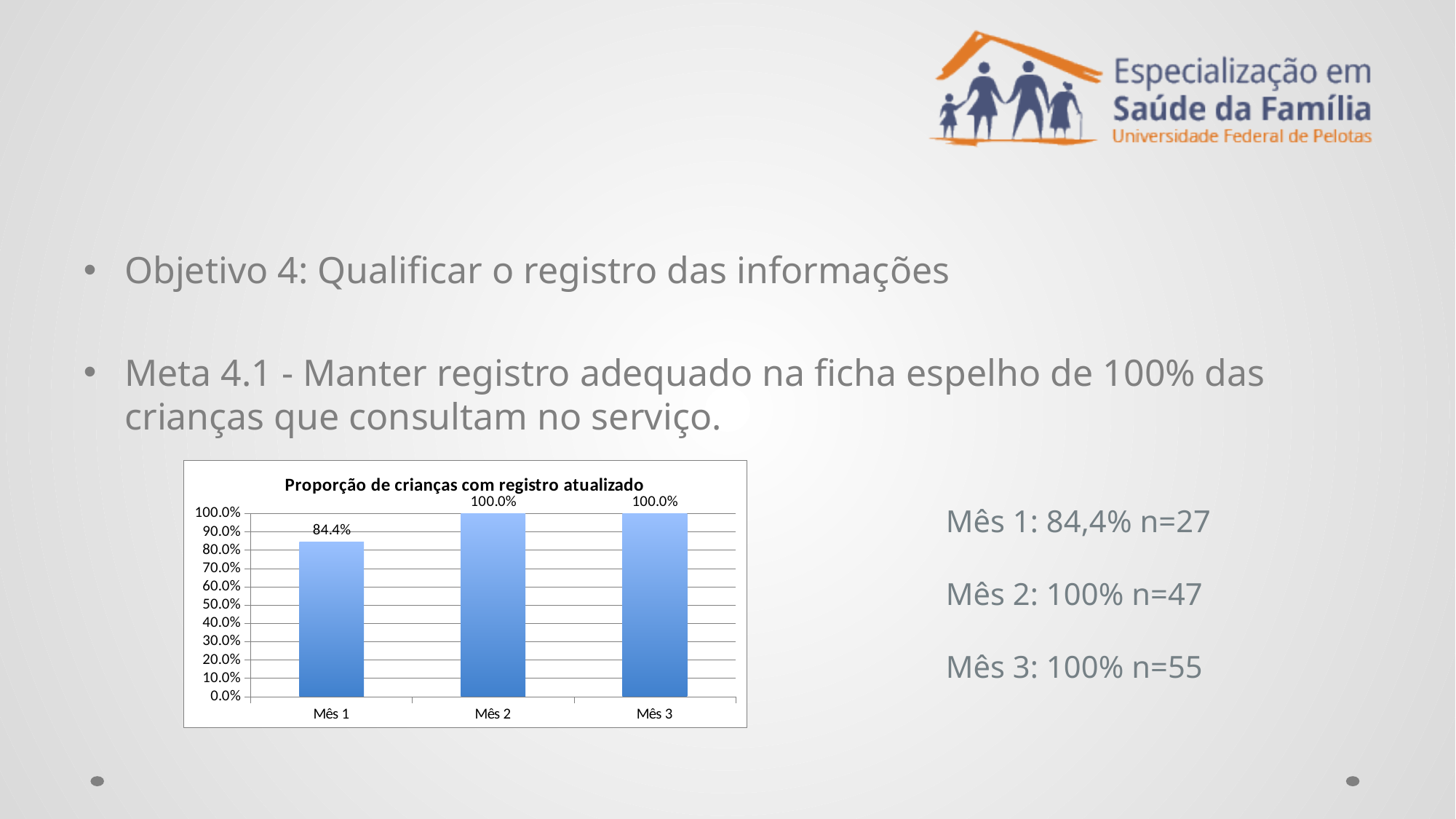
What kind of chart is shown on the slide? bar chart What is the value for Mês 1 in the chart? 84.4% What is the maximum value shown on the y axis of the chart? 100.0% Do the values rise or fall from Mês 1 to Mês 2? rise Which month has the lowest proportion of children with updated records? Mês 1 Which is larger, the value for Mês 1 or the value for Mês 3? Mês 3 What is the difference between the values for Mês 2 and Mês 1? 15.6% Is the value for Mês 1 greater or less than 90.0%? less What is the value for Mês 2 in the chart? 100.0% What is the title of the chart? Proporção de crianças com registro atualizado What is the value for Mês 3 in the chart? 100.0% How many categories are shown on the x axis of the chart? 3